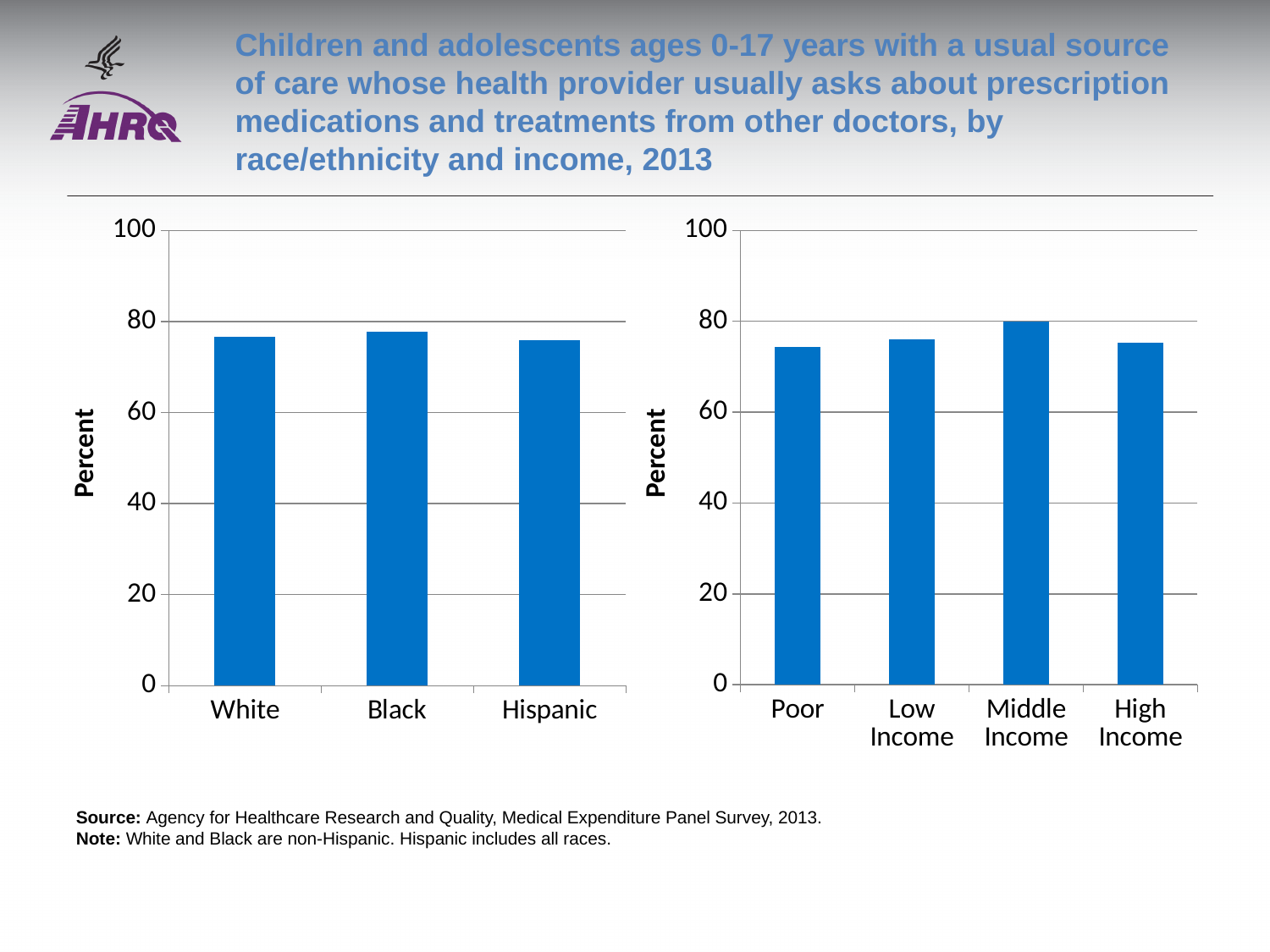
What is the label on the y axis of the right chart (by income)? Percent On the left chart (by race/ethnicity), is the value for Black greater or less than 60? greater What kind of chart is the left chart (by race/ethnicity)? Bar chart On the right chart (by income), is the value for High Income greater or less than 60? greater On the right chart (by income), which income group has the highest value? Middle Income What is the highest value shown on the y axis of the left chart (by race/ethnicity)? 100 On the right chart (by income), which is larger, the value for Middle Income or the value for Poor? Middle Income On the left chart (by race/ethnicity), is the value for White greater or less than 80? less On the left chart (by race/ethnicity), how many categories are shown on the x axis? 3 On the right chart (by income), how many categories are shown on the x axis? 4